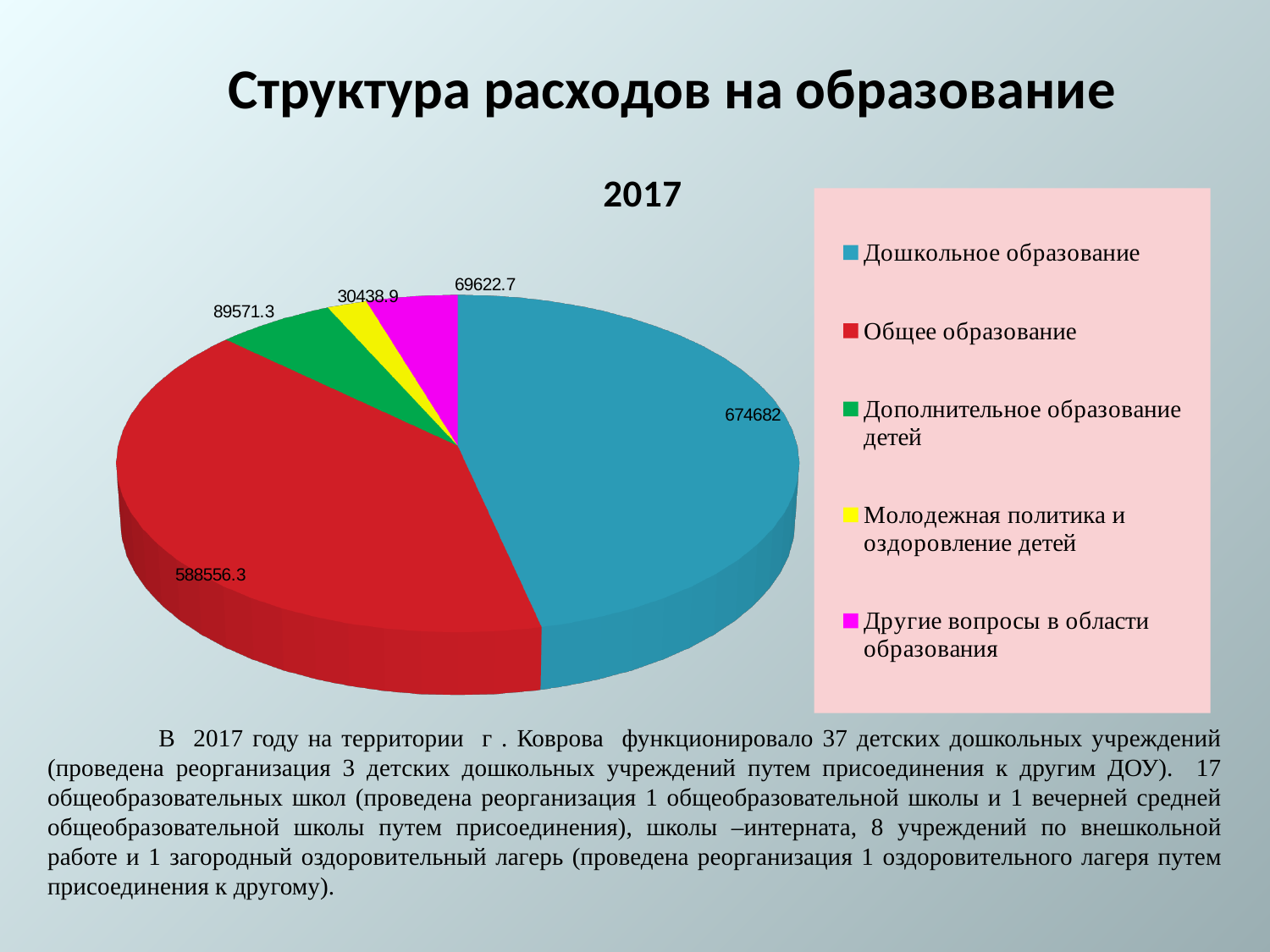
What is the value for Молодежная политика и оздоровление детей in the pie chart? 30438.9 Which is larger: the value for Дополнительное образование детей or the value for Другие вопросы в области образования? Дополнительное образование детей How many categories does the pie chart have? 5 What type of chart is shown on the slide? Pie chart What is the value for Другие вопросы в области образования in the pie chart? 69622.7 What year is shown as the title of the pie chart? 2017 What is the value for Дошкольное образование in the pie chart? 674682 Which category has the smallest slice in the pie chart? Молодежная политика и оздоровление детей Which category has the largest slice in the pie chart? Дошкольное образование What is the value for Общее образование in the pie chart? 588556.3 What is the value for Дополнительное образование детей in the pie chart? 89571.3 What is the difference between the values for Дошкольное образование and Общее образование? 86125.7